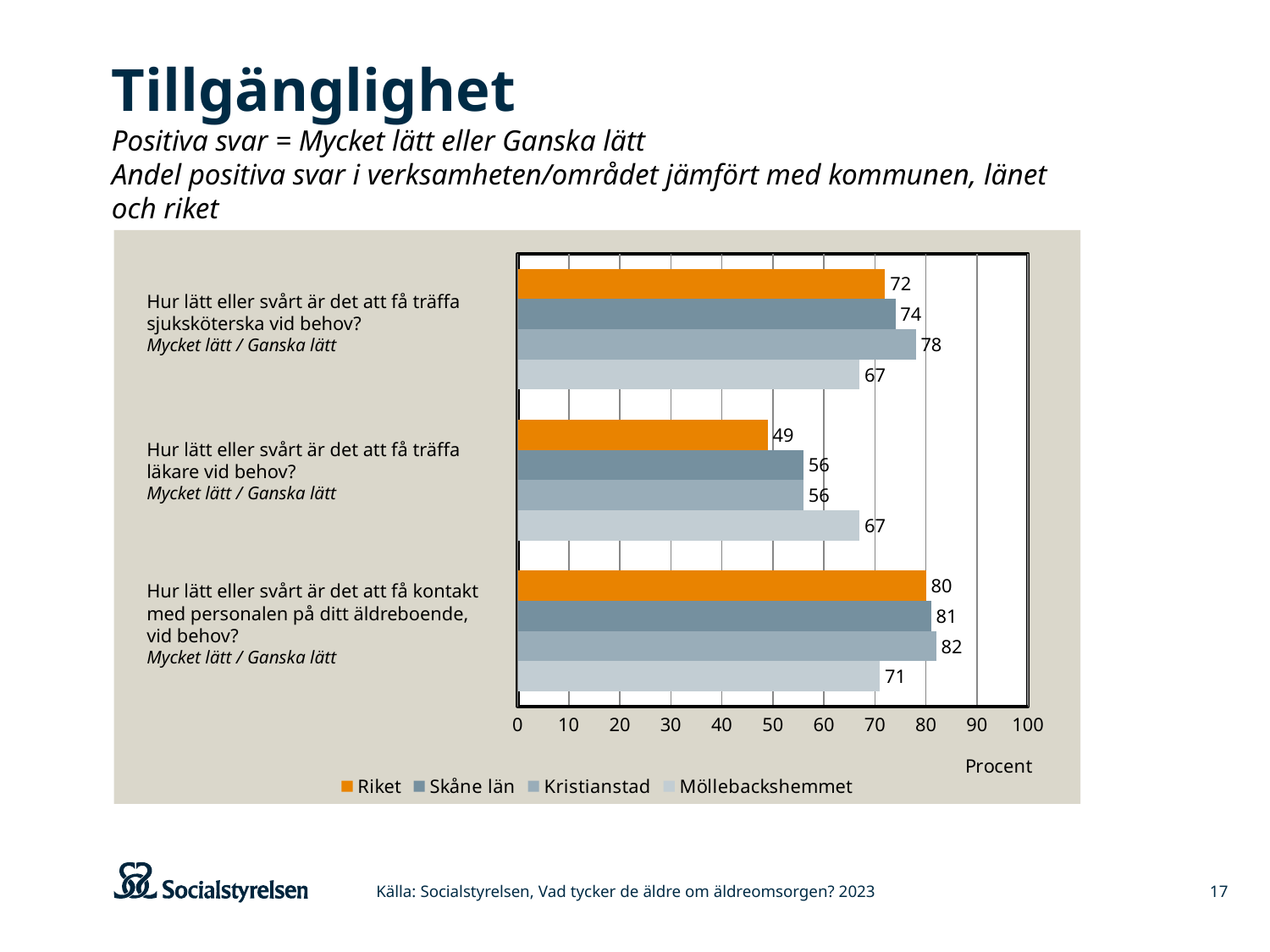
What is the value for Möllebackshemmet on the question about meeting a doctor (läkare) when needed? 67 Is the value for Riket on the question about meeting a doctor (läkare) greater or less than 50? less How many series does the legend list? 4 Which series has the highest value on the question about meeting a doctor (läkare) when needed? Möllebackshemmet How many questions (categories) are shown on the chart? 3 What is the value for Riket on the question about meeting a nurse (sjuksköterska) when needed? 72 What kind of chart is shown on the slide? Bar chart What is the difference between Kristianstad and Möllebackshemmet on the question about meeting a nurse (sjuksköterska)? 11 Which series has the lowest value on the question about getting in contact with staff at the care home (kontakt med personalen)? Möllebackshemmet What unit label is shown below the x axis of the chart? Procent Which is larger on the question about meeting a doctor (läkare): the value for Riket or the value for Skåne län? Skåne län What is the value for Kristianstad on the question about getting in contact with staff at the care home (kontakt med personalen)? 82